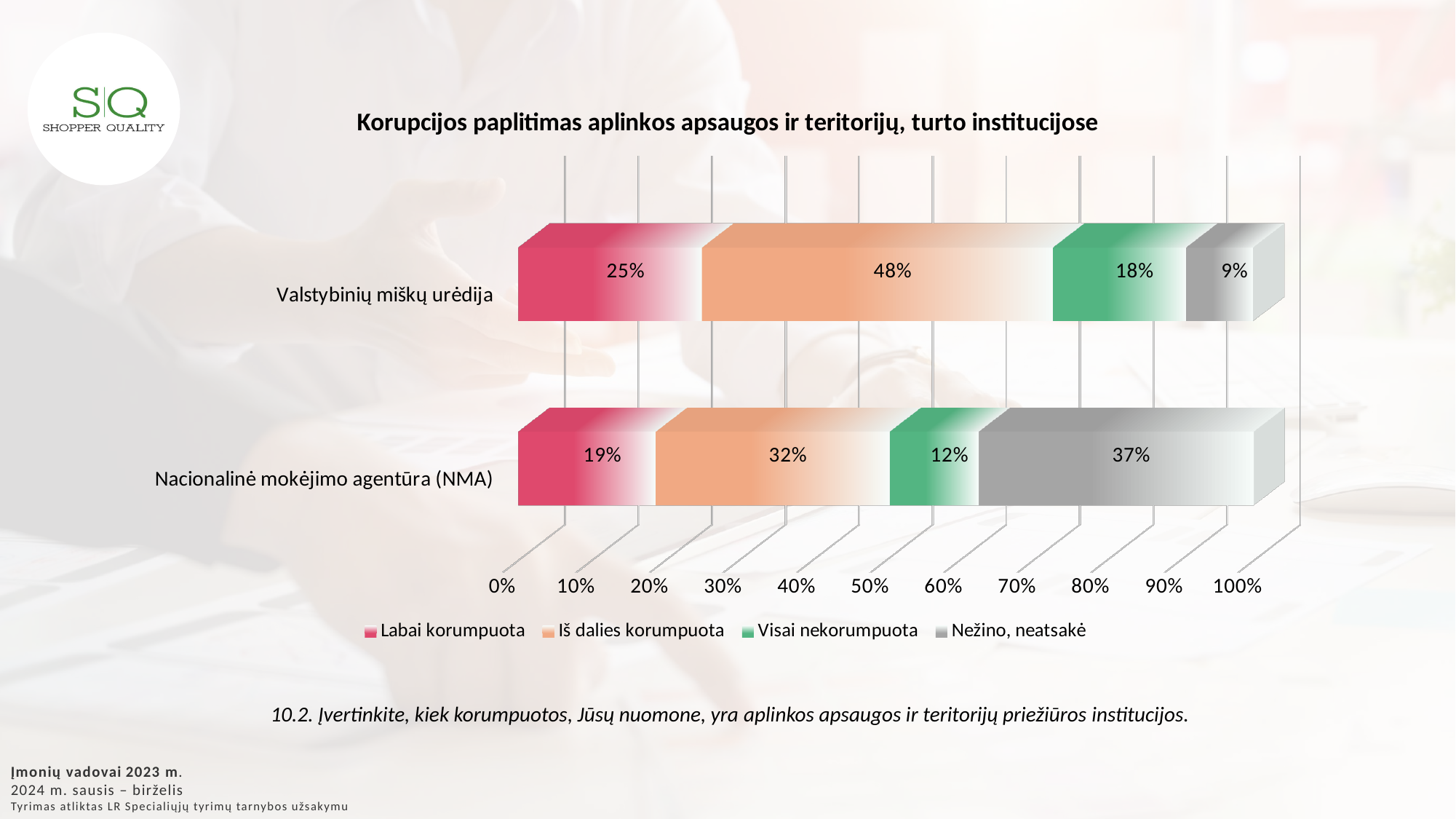
Which institution has the higher 'Iš dalies korumpuota' value? Valstybinių miškų urėdija What is the total of the stacked bar for Valstybinių miškų urėdija? 100% What is the 'Iš dalies korumpuota' value for Nacionalinė mokėjimo agentūra (NMA)? 32% What is the title of the chart? Korupcijos paplitimas aplinkos apsaugos ir teritorijų, turto institucijose What type of chart is shown on the slide? Stacked bar chart Which segment is the largest in the bar for Nacionalinė mokėjimo agentūra (NMA)? Nežino, neatsakė What is the difference between the 'Nežino, neatsakė' values for Nacionalinė mokėjimo agentūra (NMA) and Valstybinių miškų urėdija? 28% What is the 'Nežino, neatsakė' value for Nacionalinė mokėjimo agentūra (NMA)? 37% What is the 'Visai nekorumpuota' value for Valstybinių miškų urėdija? 18% How many institutions (categories) are shown in the chart? 2 What is the 'Labai korumpuota' value for Valstybinių miškų urėdija? 25% How many series does the legend list? 4